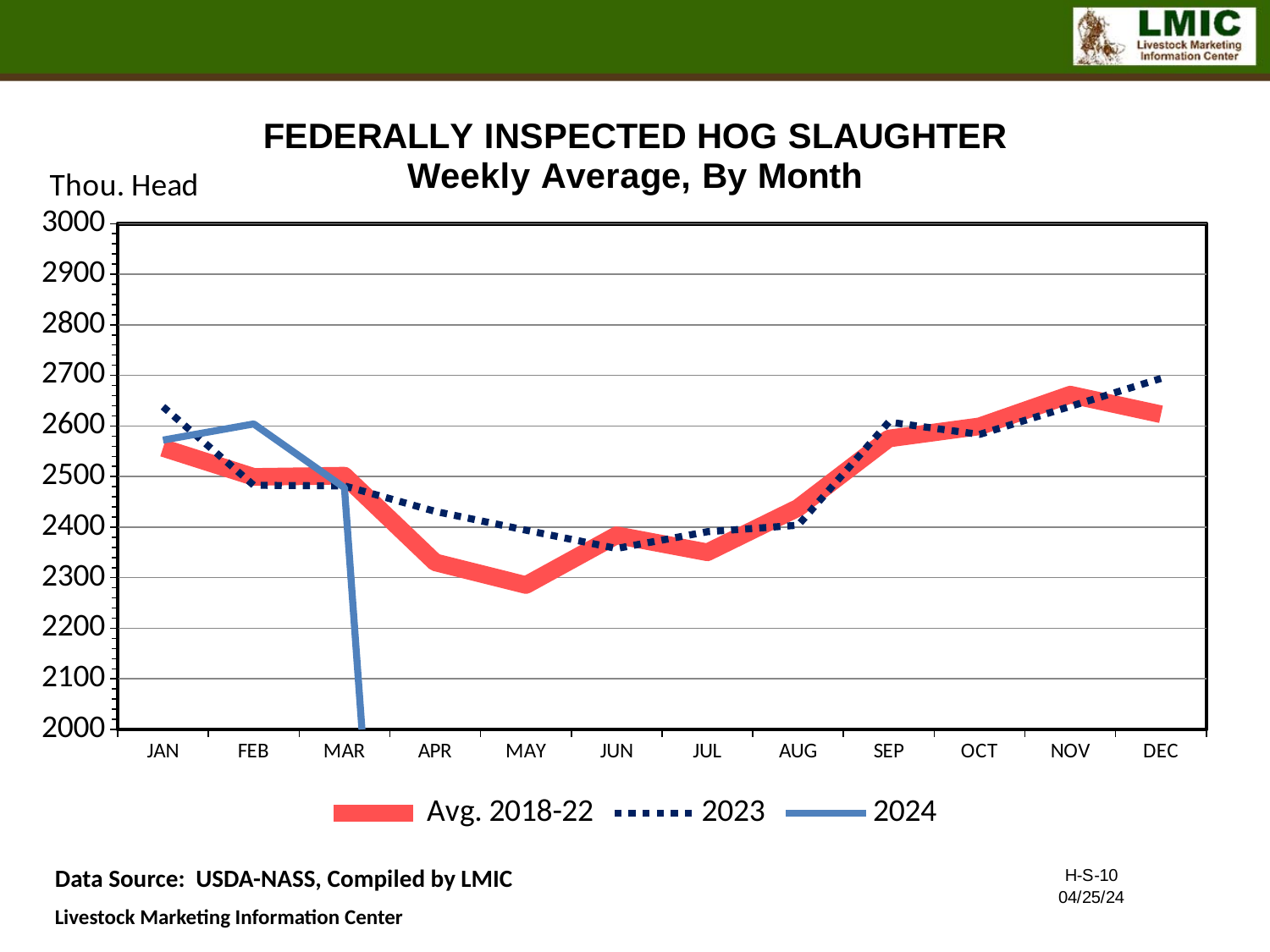
How many series does the legend list? 3 In JAN, which series is higher: 2023 or Avg. 2018-22? 2023 In which month is the Avg. 2018-22 series at its lowest? MAY What unit label is shown above the y axis? Thou. Head How many months are shown along the x axis? 12 Is the 2023 value for DEC greater or less than 2600? greater In APR, which series is higher: 2023 or Avg. 2018-22? 2023 What kind of chart is shown on the slide? line chart Is the Avg. 2018-22 value for MAY greater or less than 2400? less In which month is the 2023 series at its highest? DEC Is the 2024 value for FEB greater or less than 2500? greater Does the Avg. 2018-22 series rise or fall from JAN to MAY? fall